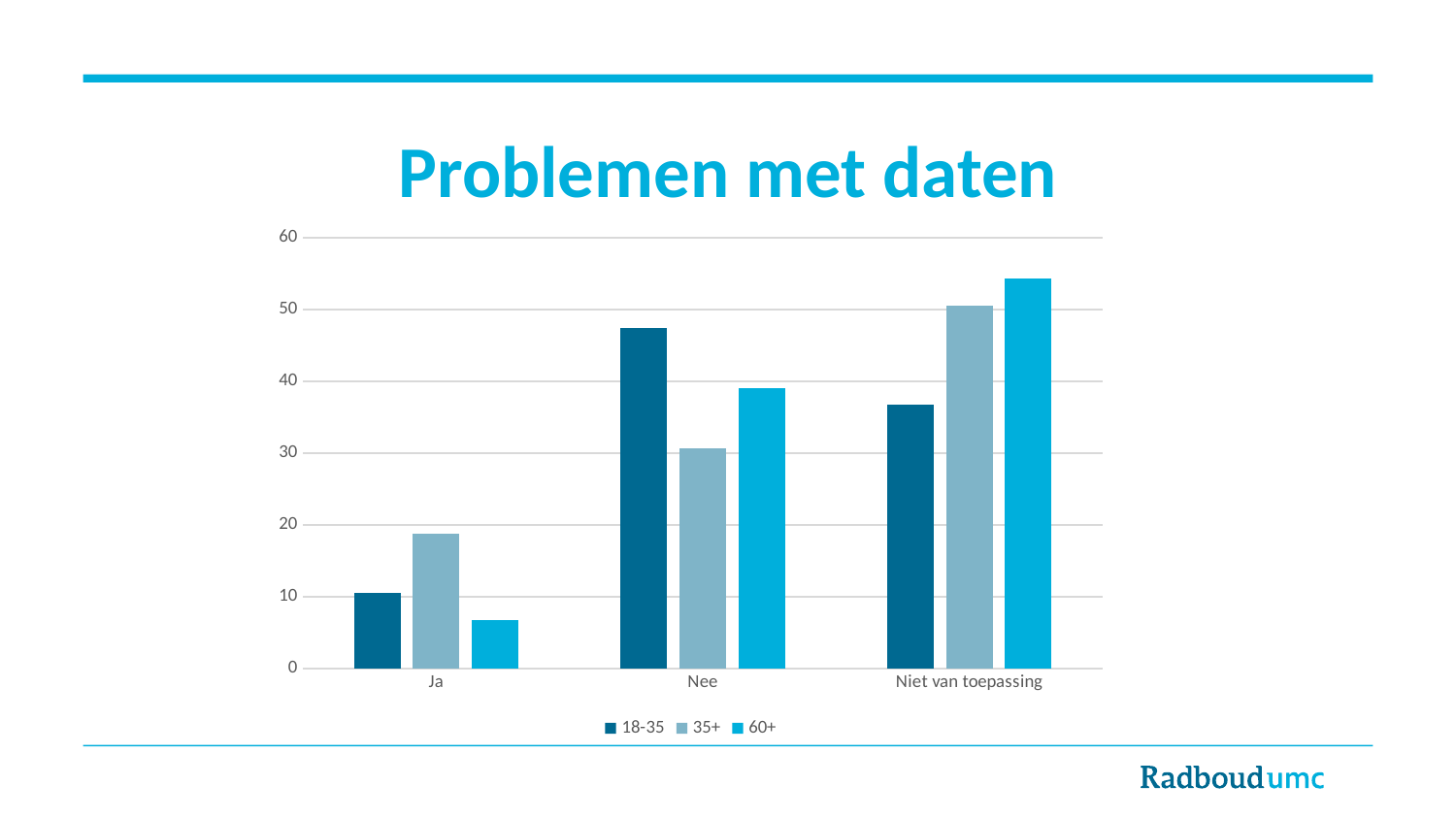
Is the value for 18-35 in the Nee category greater or less than 40? greater What kind of chart is shown on the slide? bar chart How many categories are shown on the x axis? 3 Is the value for 18-35 in the Niet van toepassing category greater or less than 40? less Is the value for 60+ in the Ja category greater or less than 10? less In which category is the 18-35 series highest? Nee In which category is the 35+ series lowest? Ja In the Nee category, which is larger: the value for 18-35 or the value for 60+? 18-35 What is the title of the chart? Problemen met daten How many series does the legend list? 3